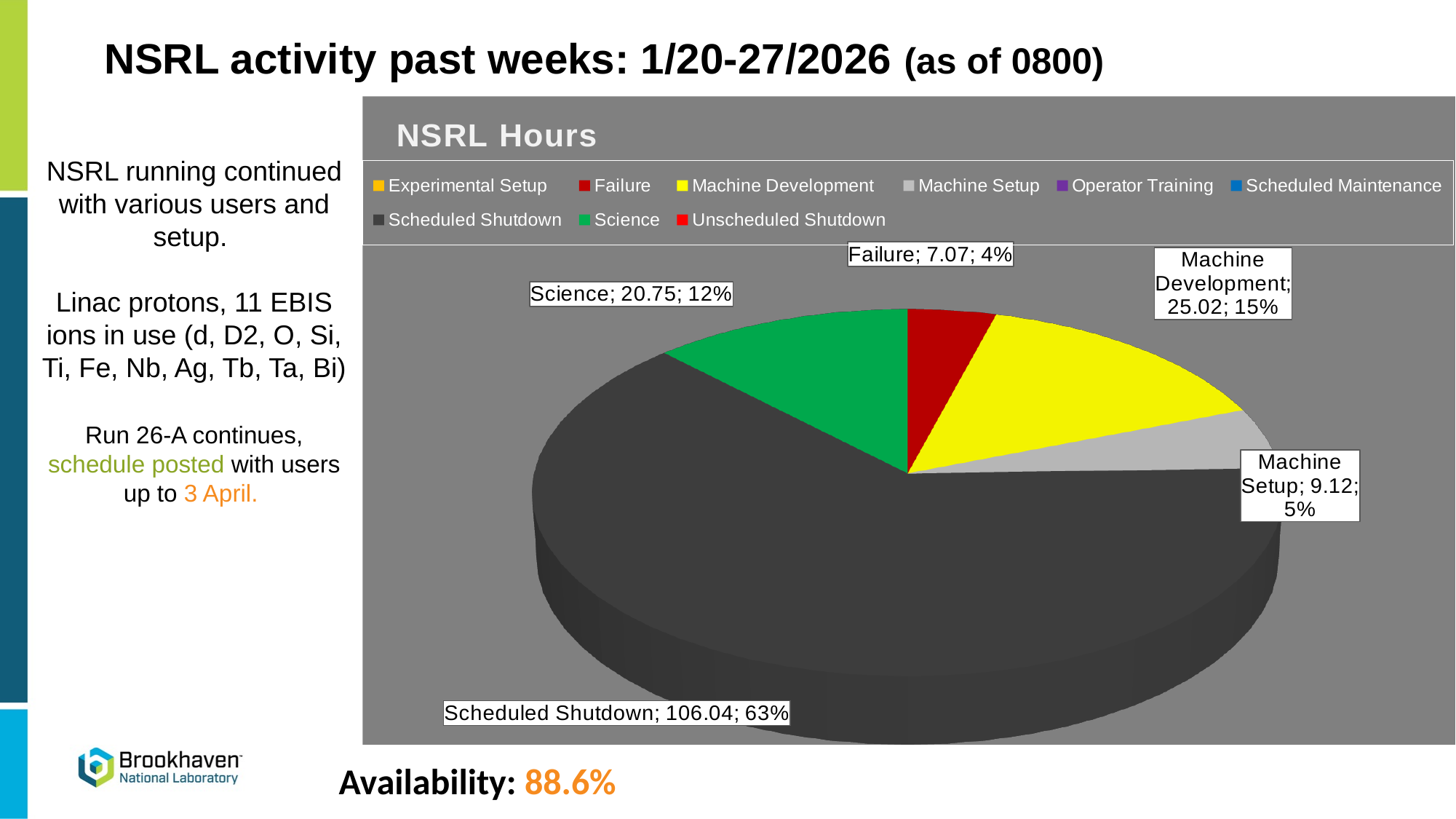
How many hours are labelled for Scheduled Shutdown? 106.04 How many hours are labelled for Failure? 7.07 What is the title of the chart? NSRL Hours Which labelled category has the smallest slice of the pie? Failure What share of the pie does Machine Setup represent? 5% What kind of chart is shown on the slide? pie chart How many hours are labelled for Science? 20.75 What is the difference in hours between Machine Development and Science? 4.27 Which labelled category has the largest slice of the pie? Scheduled Shutdown How many hours are labelled for Machine Development? 25.02 How many entries does the chart legend list? 9 What share of the pie does Scheduled Shutdown represent? 63%